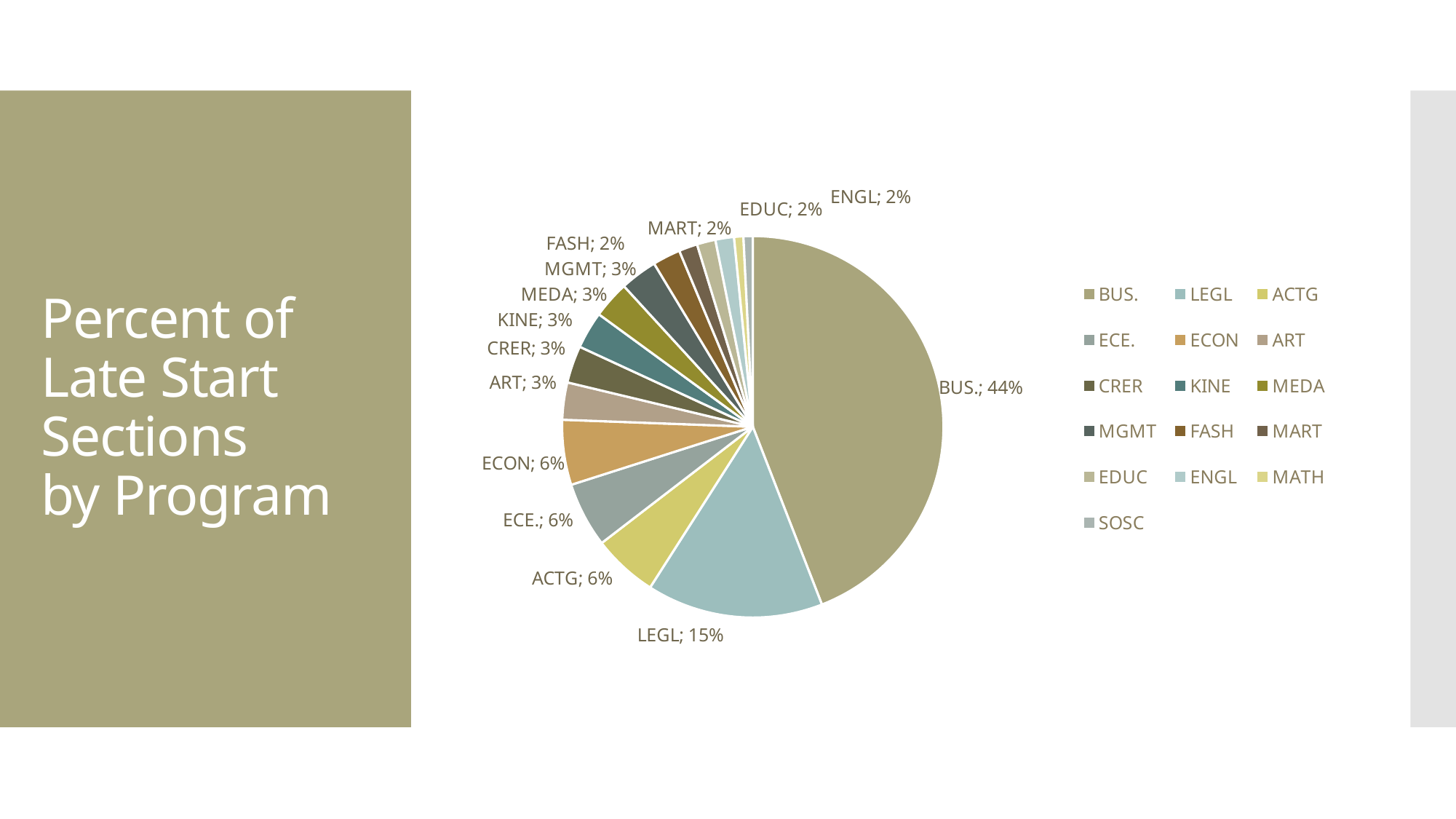
What is the title of the slide? Percent of Late Start Sections by Program Which has a larger share, LEGL or ECE.? LEGL What percentage is shown for LEGL? 15% What percentage is shown for ECON? 6% Which has a larger share, ACTG or ART? ACTG Which program has the largest slice of the pie? BUS. What percentage is shown for KINE? 3% How many programs are listed in the legend? 16 What share of late start sections does BUS. account for? 44% What kind of chart is shown on the slide? Pie chart What percentage is shown for FASH? 2% How many percentage points larger is the BUS. share than the LEGL share? 29